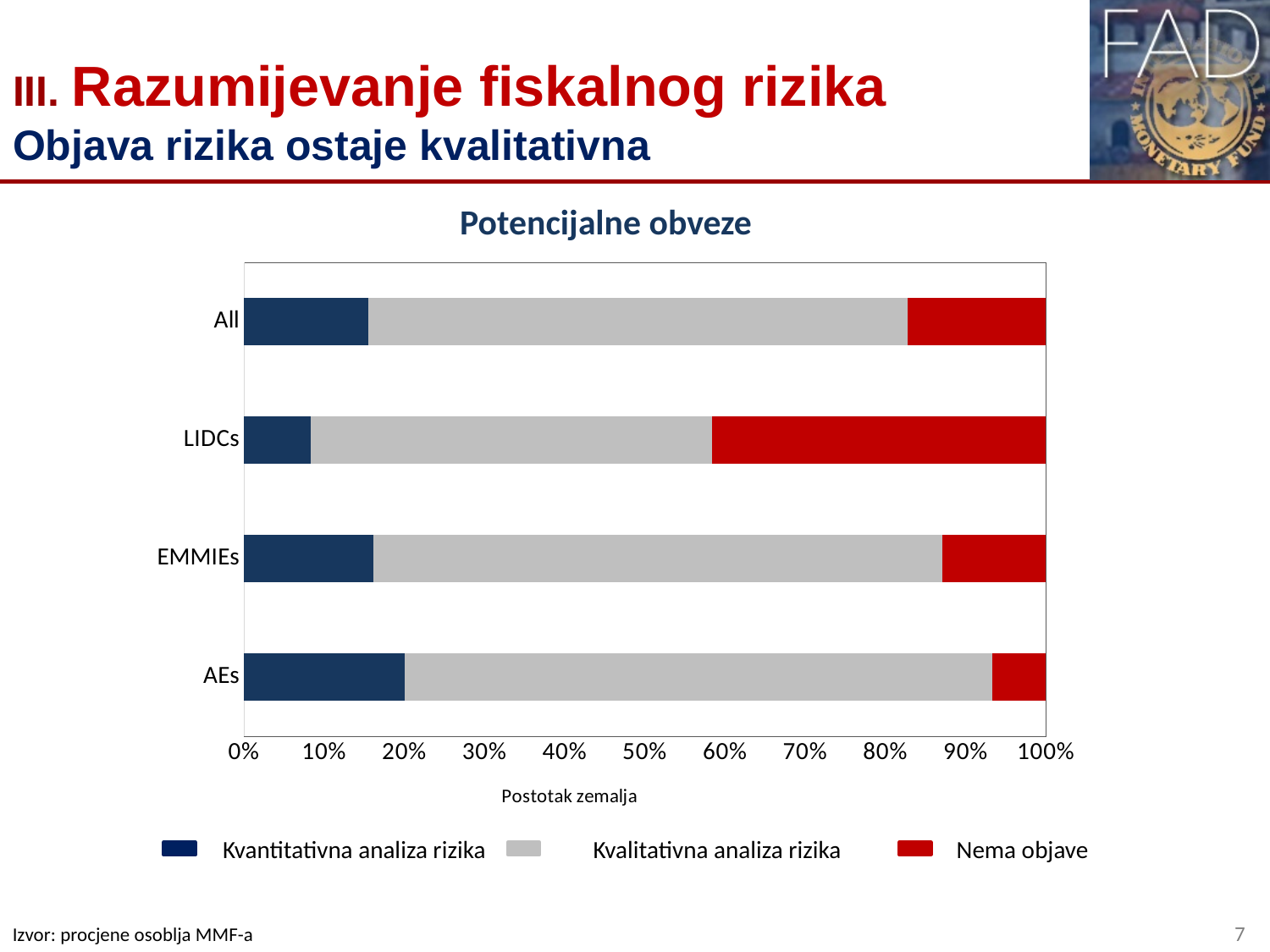
Is the 'Nema objave' value for LIDCs greater or less than 30%? greater Is the 'Kvantitativna analiza rizika' value for AEs greater or less than 10%? greater What kind of chart is shown on the slide? Stacked bar chart Which category has the smallest 'Nema objave' segment? AEs Is the 'Nema objave' share for LIDCs larger or smaller than for EMMIEs? Larger How many series does the legend list? 3 What is the title of the chart? Potencijalne obveze What is the label of the horizontal axis? Postotak zemalja Which category has the smallest 'Kvantitativna analiza rizika' segment? LIDCs Which category has the largest 'Kvantitativna analiza rizika' segment? AEs How many country groups (categories) are shown on the chart? 4 Which category has the largest 'Nema objave' segment? LIDCs